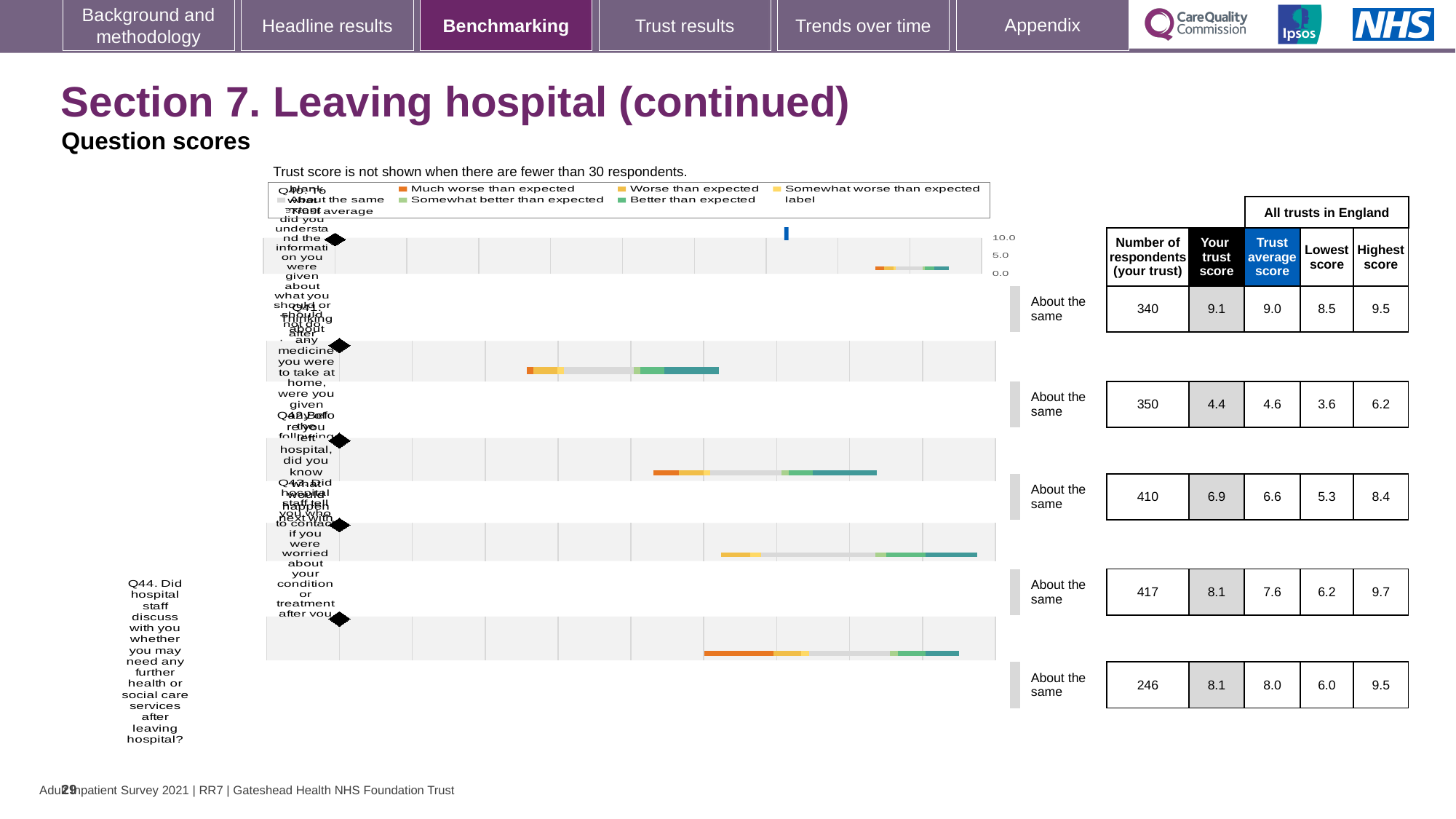
What kind of chart is used to show the question scores on this slide? bar chart For Q44 (the last row), which is larger: your trust score or the trust average score? Your trust score (8.1) For Q44 (the last row), what is the difference between your trust score and the trust average score? 0.1 Which row has the highest 'Your trust score', and what is it? The first row, 9.1 What is the trust average score for the first row of the chart? 9.0 What is the highest score across all trusts in England for Q44 (the last row)? 9.5 Is the 'Your trust score' for the second row greater or less than 5.0? less What is the lowest 'Your trust score' shown in the table? 4.4 What is the 'Your trust score' for Q44 (the last row, about needing further health or social care services after leaving hospital)? 8.1 How many respondents from your trust answered Q44 (the last row)? 246 How many questions (rows) are plotted in the benchmarking chart? 5 What benchmark category label is shown next to every question in the chart? About the same